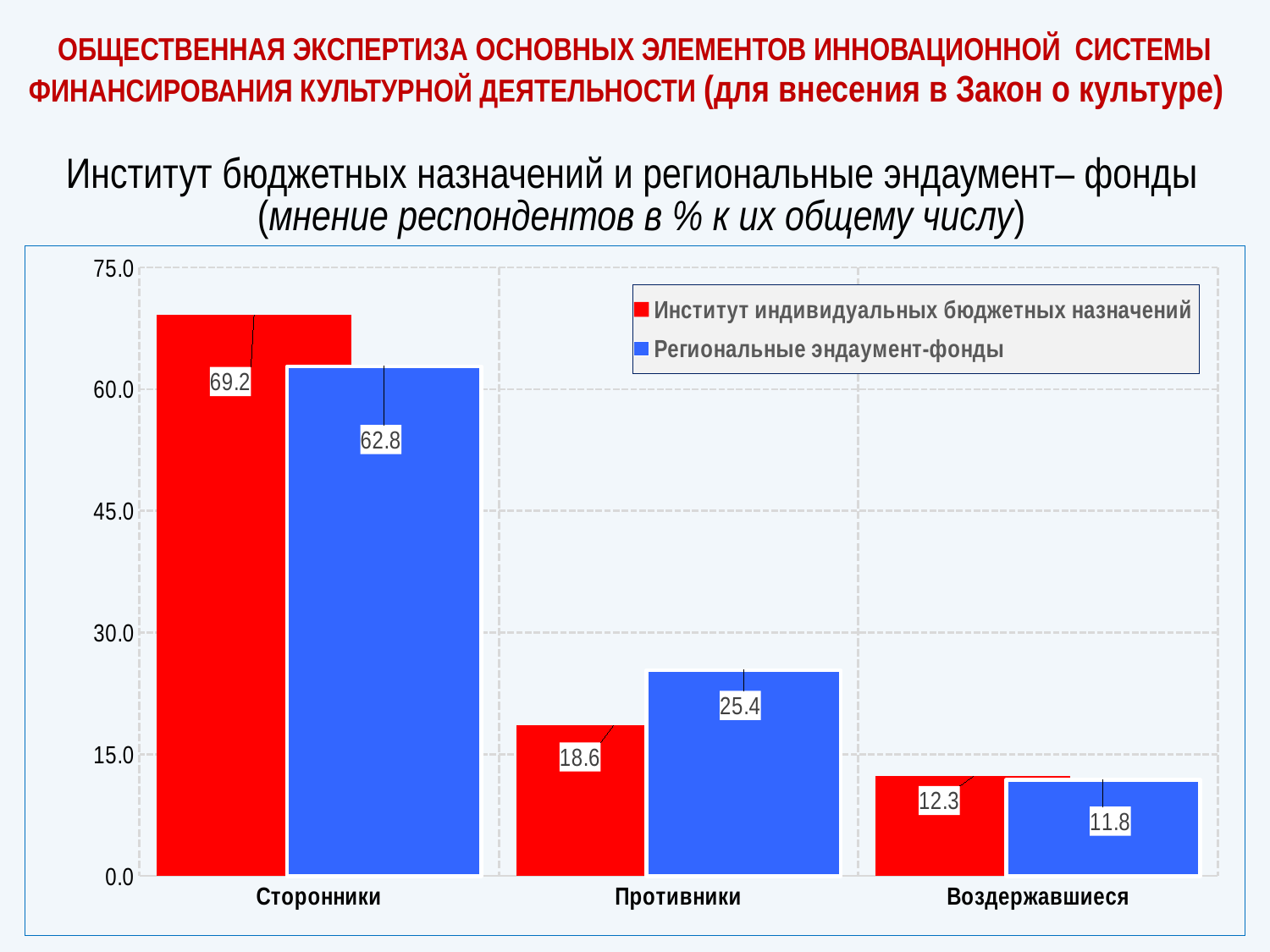
What is the value for Сторонники in the Региональные эндаумент-фонды series? 62.8 How many categories are shown on the x axis? 3 How many series does the legend list? 2 What is the difference between the Региональные эндаумент-фонды and Институт индивидуальных бюджетных назначений values for Противники? 6.8 What is the value for Воздержавшиеся in the Институт индивидуальных бюджетных назначений series? 12.3 What is the value for Сторонники in the Институт индивидуальных бюджетных назначений series? 69.2 What is the value for Противники in the Региональные эндаумент-фонды series? 25.4 Which category has the highest value in the Региональные эндаумент-фонды series? Сторонники Which category has the lowest value in the Институт индивидуальных бюджетных назначений series? Воздержавшиеся What is the difference between the Институт индивидуальных бюджетных назначений and Региональные эндаумент-фонды values for Сторонники? 6.4 For Противники, which series has the larger value? Региональные эндаумент-фонды What kind of chart is shown on the slide? Bar chart